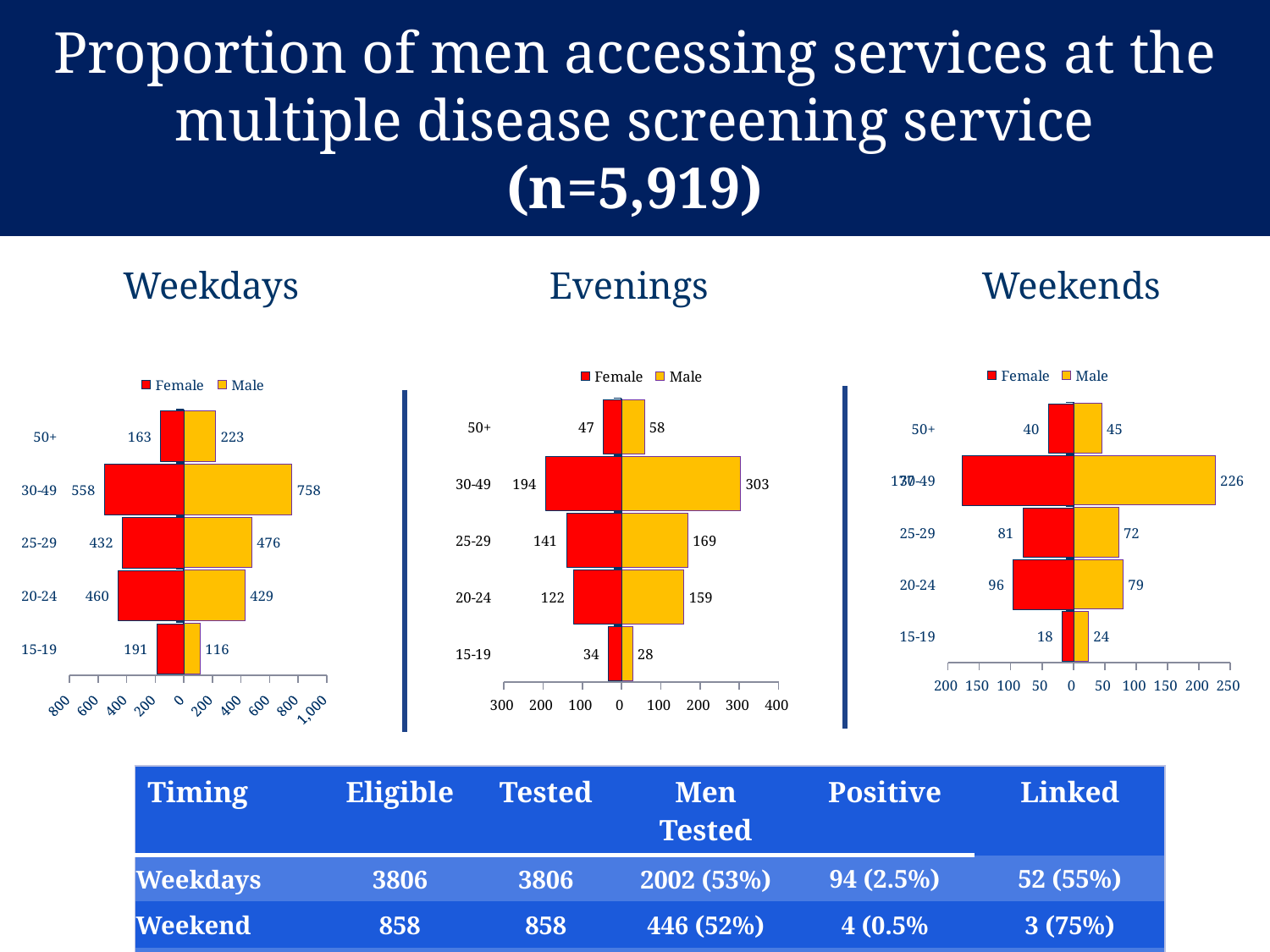
In the Weekends chart, which is larger for the 25-29 age group, the Female value or the Male value? Female In the Weekdays chart, what is the difference between the Male and Female values for the 30-49 age group? 200 In the Evenings chart, which age group has the lowest Male value? 15-19 How many age groups are shown in the Weekends chart? 5 What type of chart is the Weekdays chart? Bar chart In the Weekdays chart, what is the Male value for the 30-49 age group? 758 In the Evenings chart, what is the Male value for the 30-49 age group? 303 In the Evenings chart, what is the difference between the Male and Female values for the 20-24 age group? 37 In the Weekends chart, what is the Female value for the 20-24 age group? 96 In the Weekdays chart, what is the Female value for the 20-24 age group? 460 How many series does the legend of the Evenings chart list? 2 In the Weekdays chart, which age group has the highest Female value? 30-49